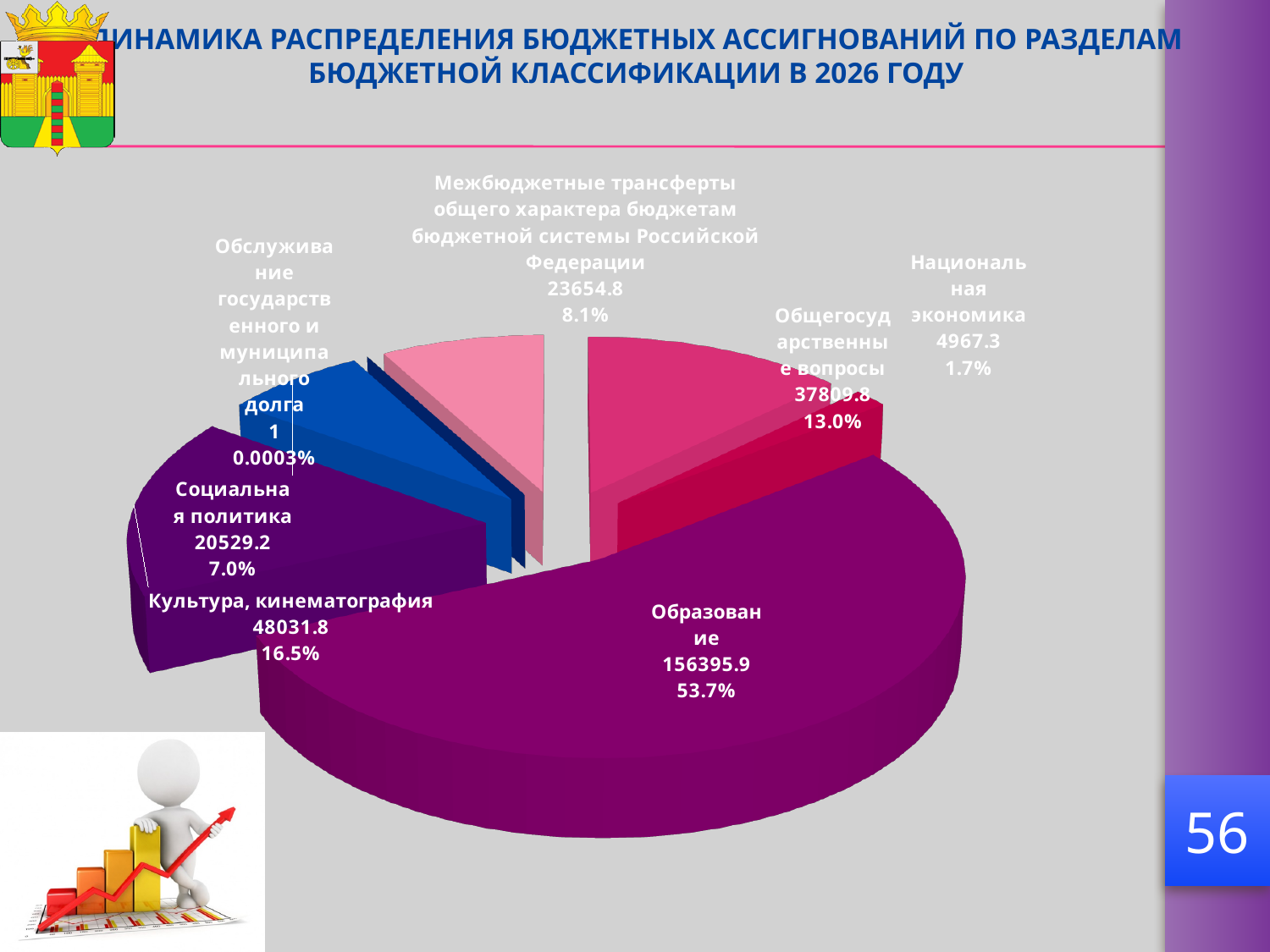
Which category has the smallest slice of the pie? Обслуживание государственного и муниципального долга What value is shown for Образование? 156395.9 What is the difference between the values for Культура, кинематография and Общегосударственные вопросы? 10222.0 Which is larger, the value for Социальная политика or the value for Межбюджетные трансферты общего характера бюджетам бюджетной системы Российской Федерации? Межбюджетные трансферты общего характера бюджетам бюджетной системы Российской Федерации Which category has the largest slice of the pie? Образование What percentage is shown for Социальная политика? 7.0% What kind of chart is shown on the slide? pie chart How many slices does the pie chart have? 7 What percentage is shown for Общегосударственные вопросы? 13.0% What share of the pie does Образование represent? 53.7% What value is shown for Культура, кинематография? 48031.8 What value is shown for Национальная экономика? 4967.3